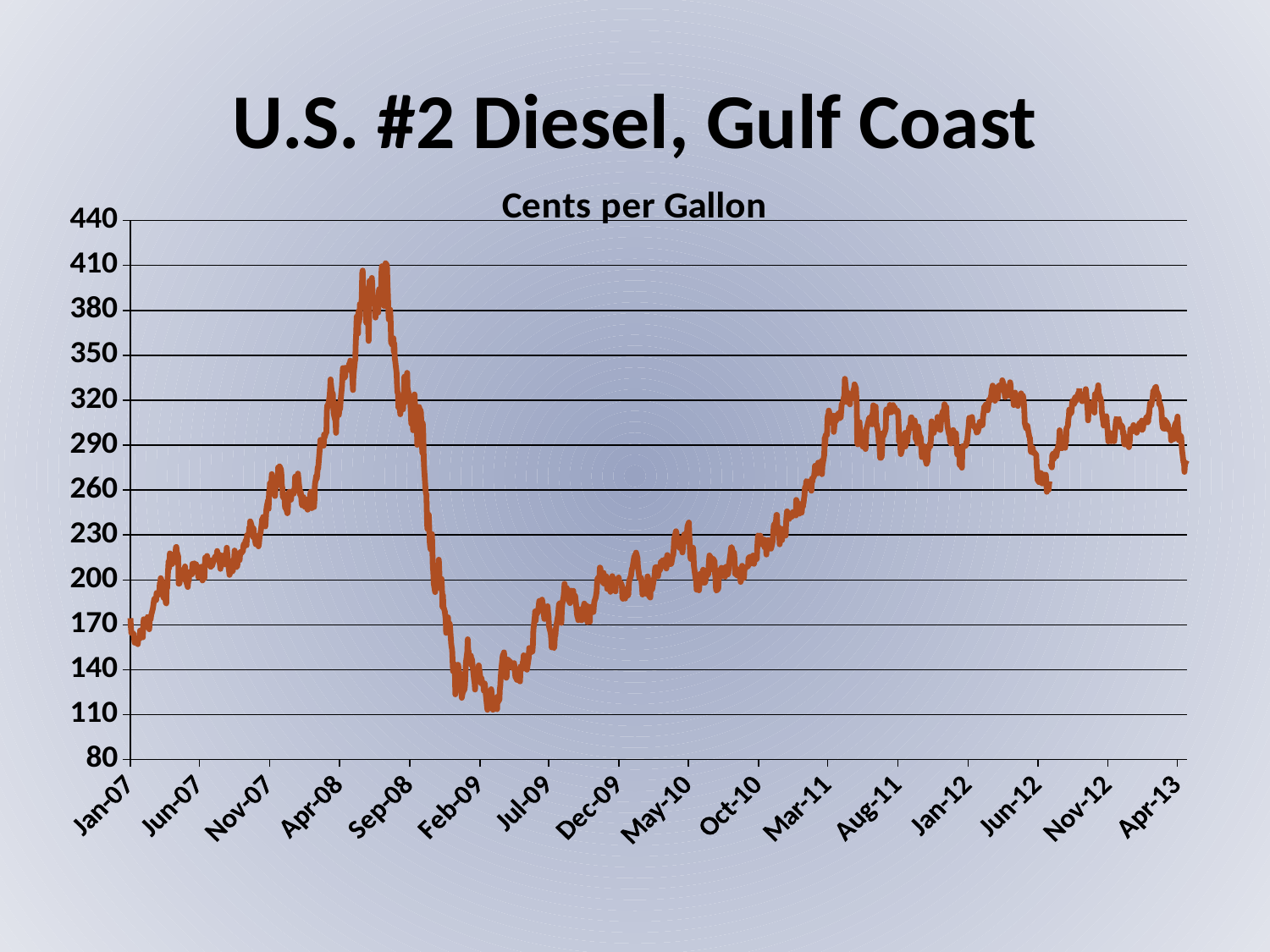
Is the value at Apr-13 greater or less than 320? less Is the value at Feb-09 greater or less than 170? less What kind of chart is shown on the slide? Line chart Which is larger, the value at Jan-07 or the value at Apr-13? Apr-13 Does the line reach its lowest value in 2007 or in 2009? 2009 Is the value at Jan-07 greater or less than 200? less How many lines are plotted on the chart? 1 Does the line reach its highest value in 2008 or in 2011? 2008 How many date labels are shown along the x axis? 16 What is the title of the chart? Cents per Gallon In what unit are the values on the chart expressed? Cents per Gallon